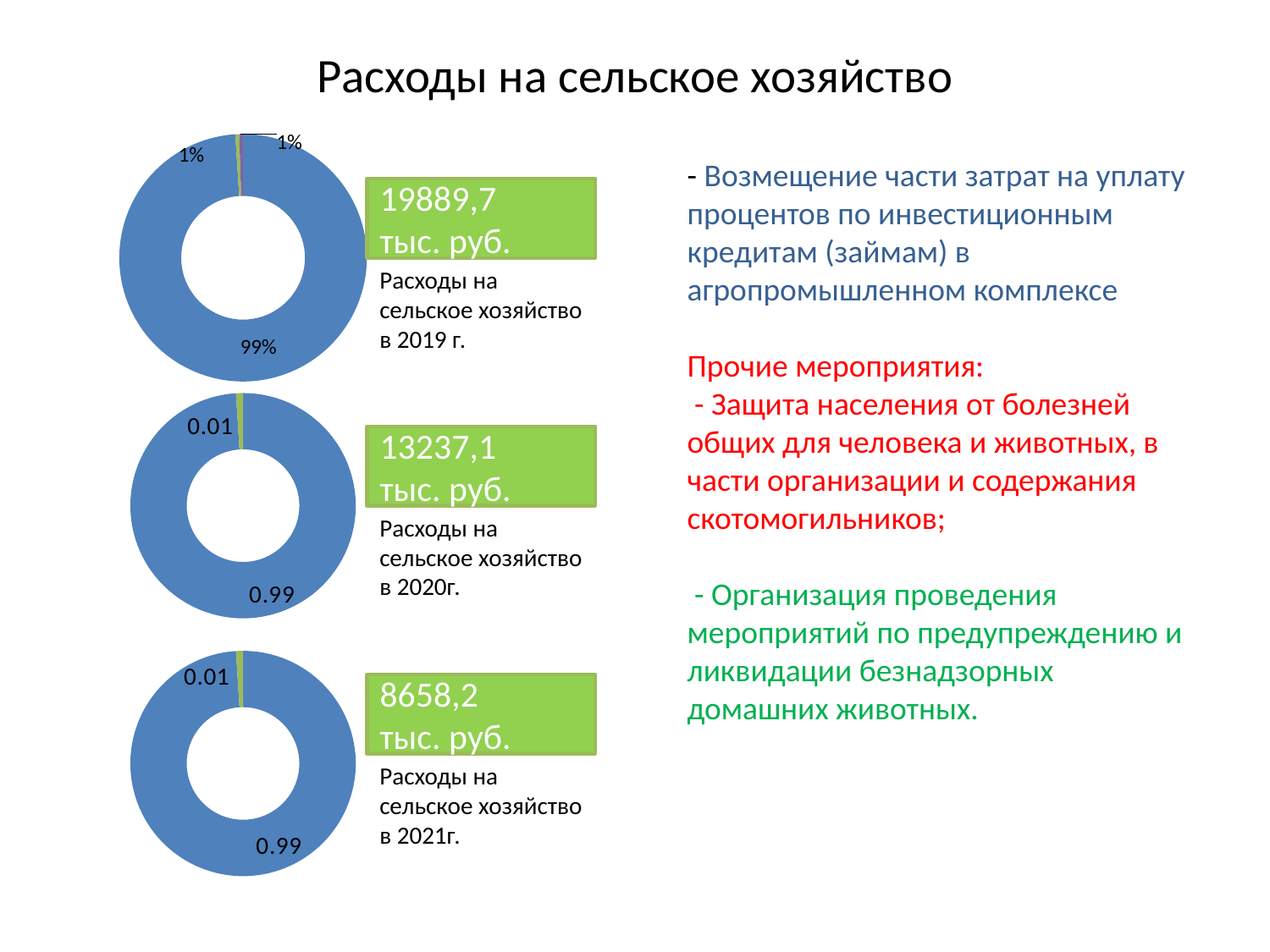
In the bottom chart (2021), what value is shown for the largest slice? 0.99 In the middle chart (2020), what value is shown for the smallest slice? 0.01 In the top chart (2019), what value is shown for each of the two small slices? 1% In the top chart (2019), what percentage is shown for the largest slice? 99% In the bottom chart (2021), what is the difference between the largest and smallest slice values? 0.98 What colour is the largest slice in each of the three doughnut charts? Blue In the middle chart (2020), how many slices are labelled? 2 In the middle chart (2020), what value is shown for the largest slice? 0.99 What kind of chart is the top chart on the left (Расходы на сельское хозяйство в 2019 г.)? Doughnut (pie) chart How many doughnut charts are shown on the slide? 3 In the top chart (2019), how many slices are labelled? 3 In the bottom chart (2021), what value is shown for the smallest slice? 0.01